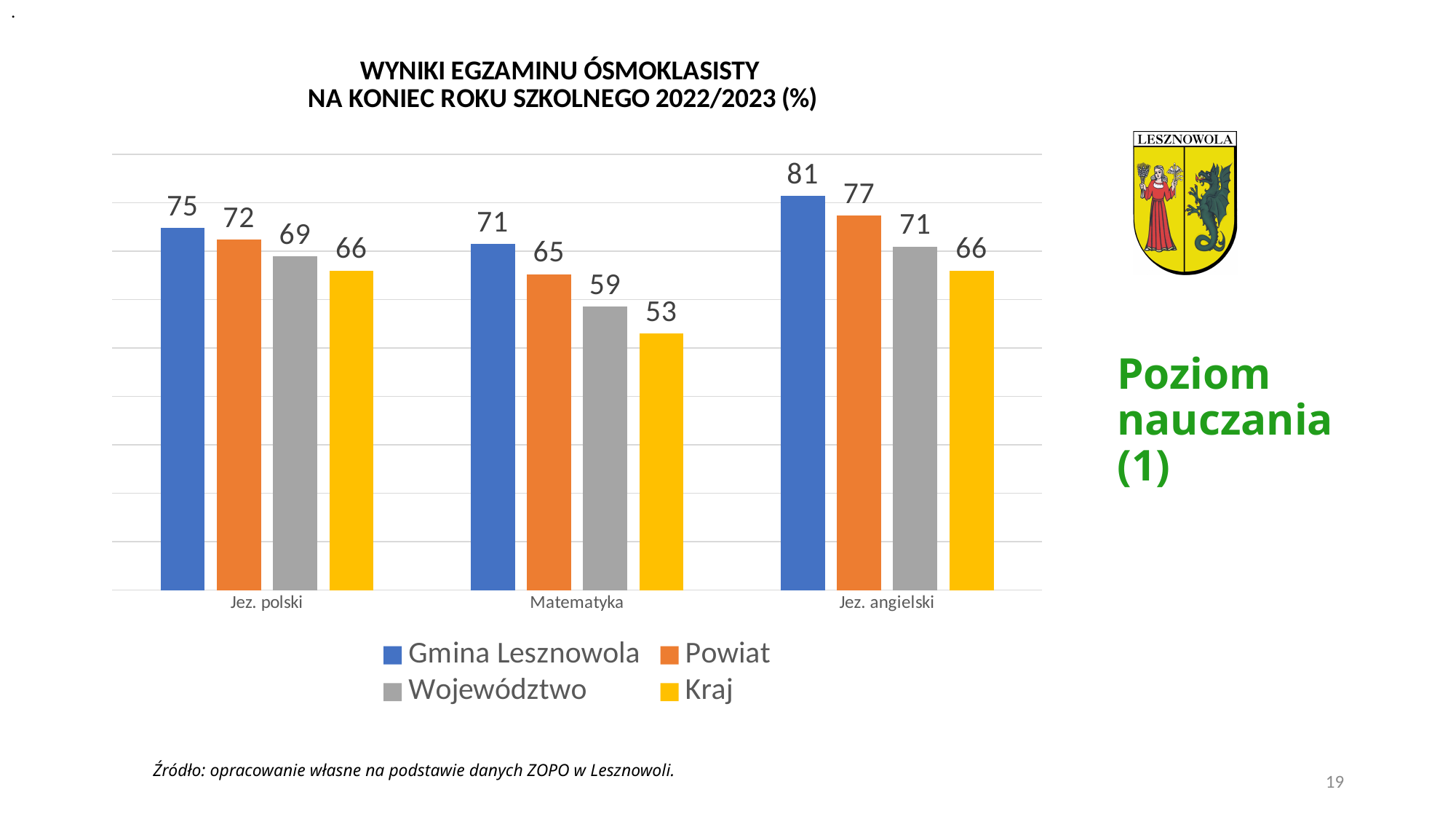
What is the value for Województwo in Matematyka? 59 What kind of chart is shown on the slide? Bar chart How many categories are shown on the x axis? 3 What is the value for Gmina Lesznowola in Jez. polski? 75 Which series has the highest value in Jez. angielski? Gmina Lesznowola What is the difference between Gmina Lesznowola and Kraj in Jez. angielski? 15 What is the value for Kraj in Matematyka? 53 What is the value for Powiat in Jez. angielski? 77 Which is larger: Gmina Lesznowola in Matematyka or Województwo in Jez. angielski? They are equal (71) How many series does the legend list? 4 Which series has the lowest value in Matematyka? Kraj What is the difference between Powiat and Województwo in Jez. polski? 3